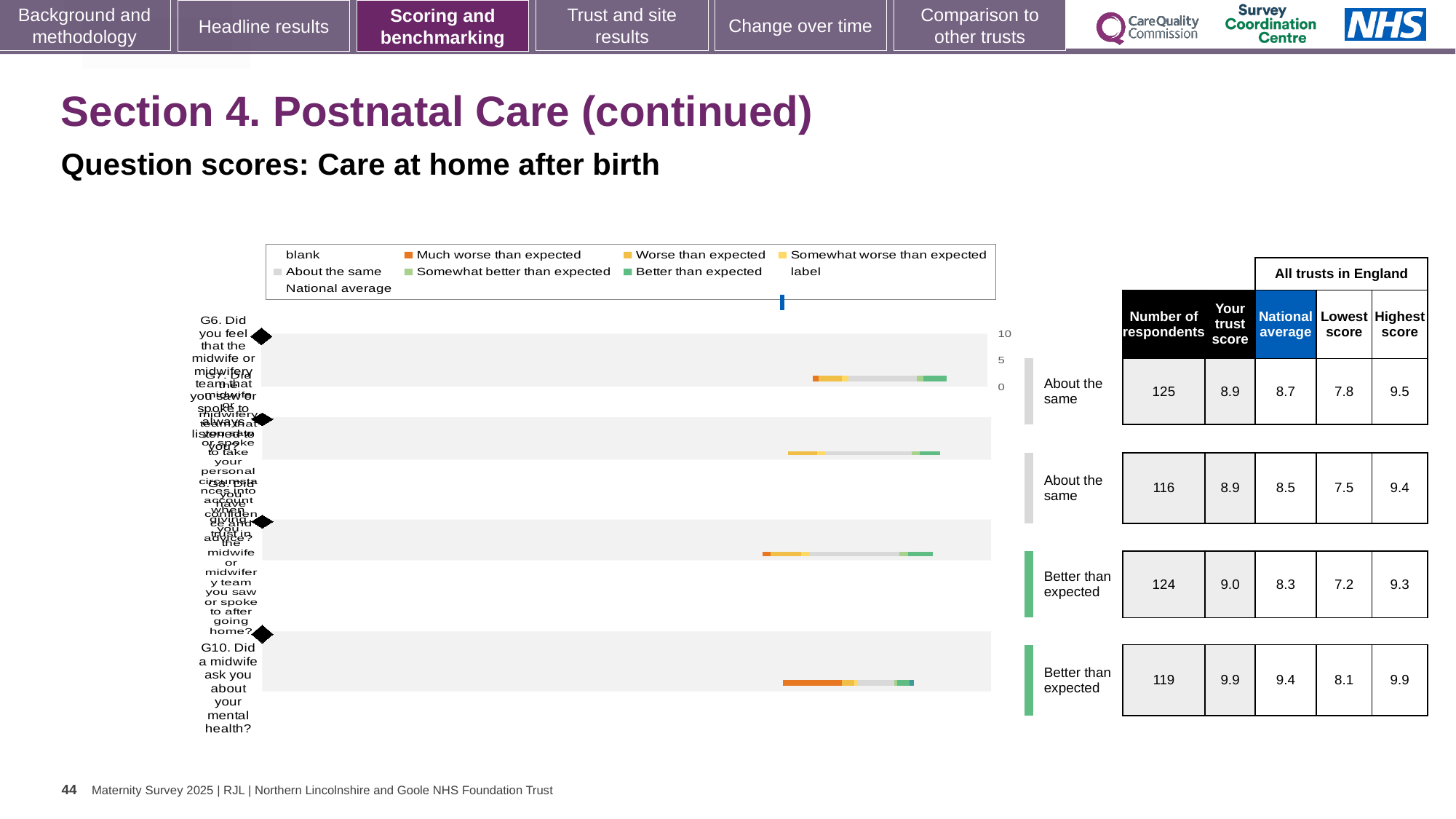
What kind of chart is shown on the slide? bar chart Is the trust score for G6 larger than the national average for G6? Yes What is the lowest score across all trusts in England for G7? 7.5 What is the number of respondents for G10 (Did a midwife ask you about your mental health?)? 119 How many question bars are plotted in the chart? 4 What is the difference between the trust score and the national average for G10? 0.5 Which colour does the legend use for 'Better than expected'? green Which colour does the legend use for 'Much worse than expected'? orange Which question has the lowest number of respondents? G7 What is the trust score for G10 (Did a midwife ask you about your mental health?)? 9.9 Which question has the highest trust score? G10 What is the national average for G6 (Did you feel that the midwife or midwifery team listened to you?)? 8.7